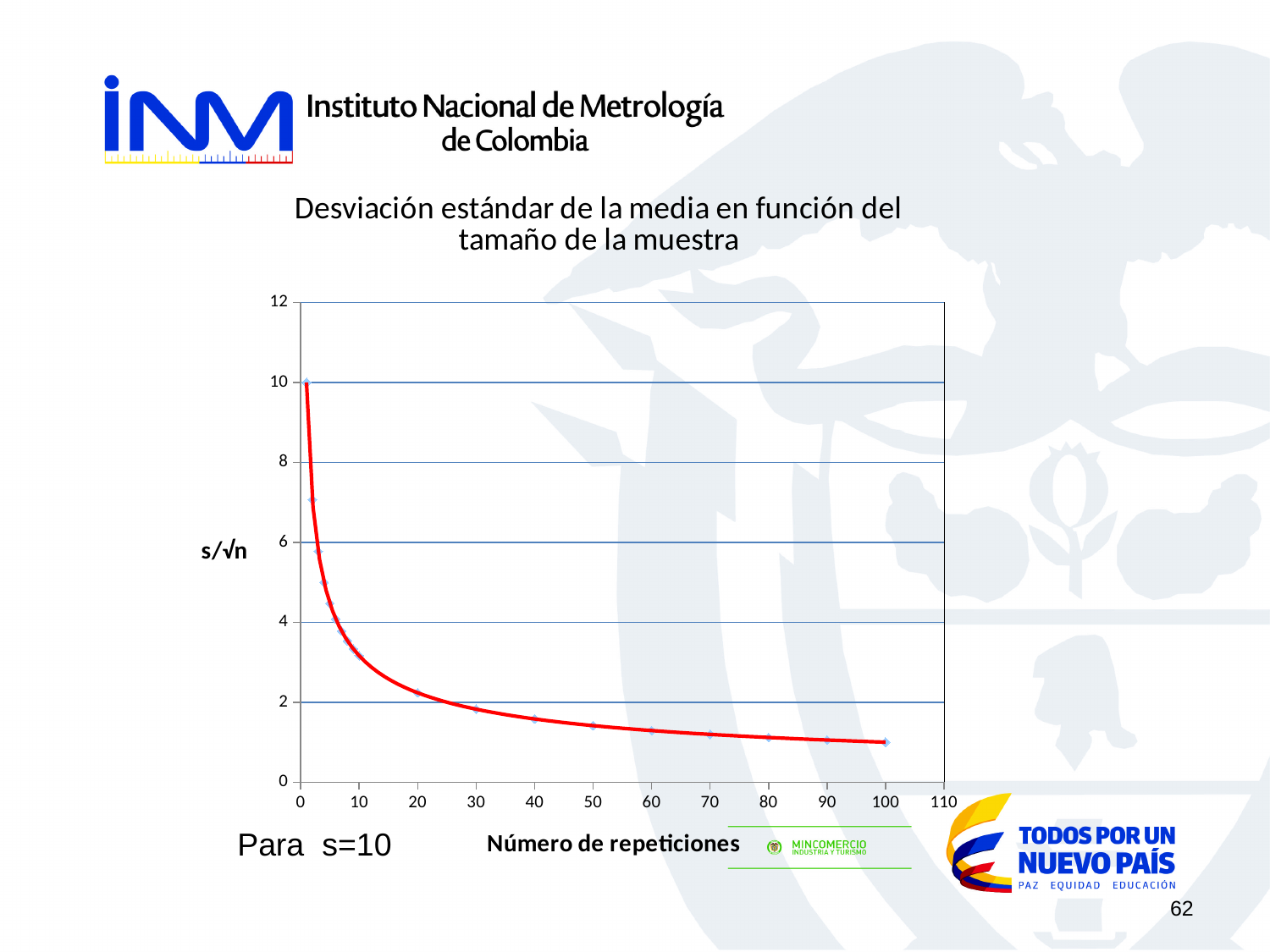
Is the value of s/√n at 100 repetitions greater or less than 2? less What is the label of the x axis? Número de repeticiones At which number of repetitions is s/√n highest? 1 What is the value of s/√n at 1 repetition? 10 Is the value of s/√n at 10 repetitions greater or less than 2? greater Which is larger, the value of s/√n at 10 repetitions or at 50 repetitions? 10 repetitions What is the title of the chart? Desviación estándar de la media en función del tamaño de la muestra At which number of repetitions is s/√n lowest? 100 Do the values rise or fall as the number of repetitions increases? fall What kind of chart is shown on the slide? line chart Is the value of s/√n at 10 repetitions greater or less than 4? less